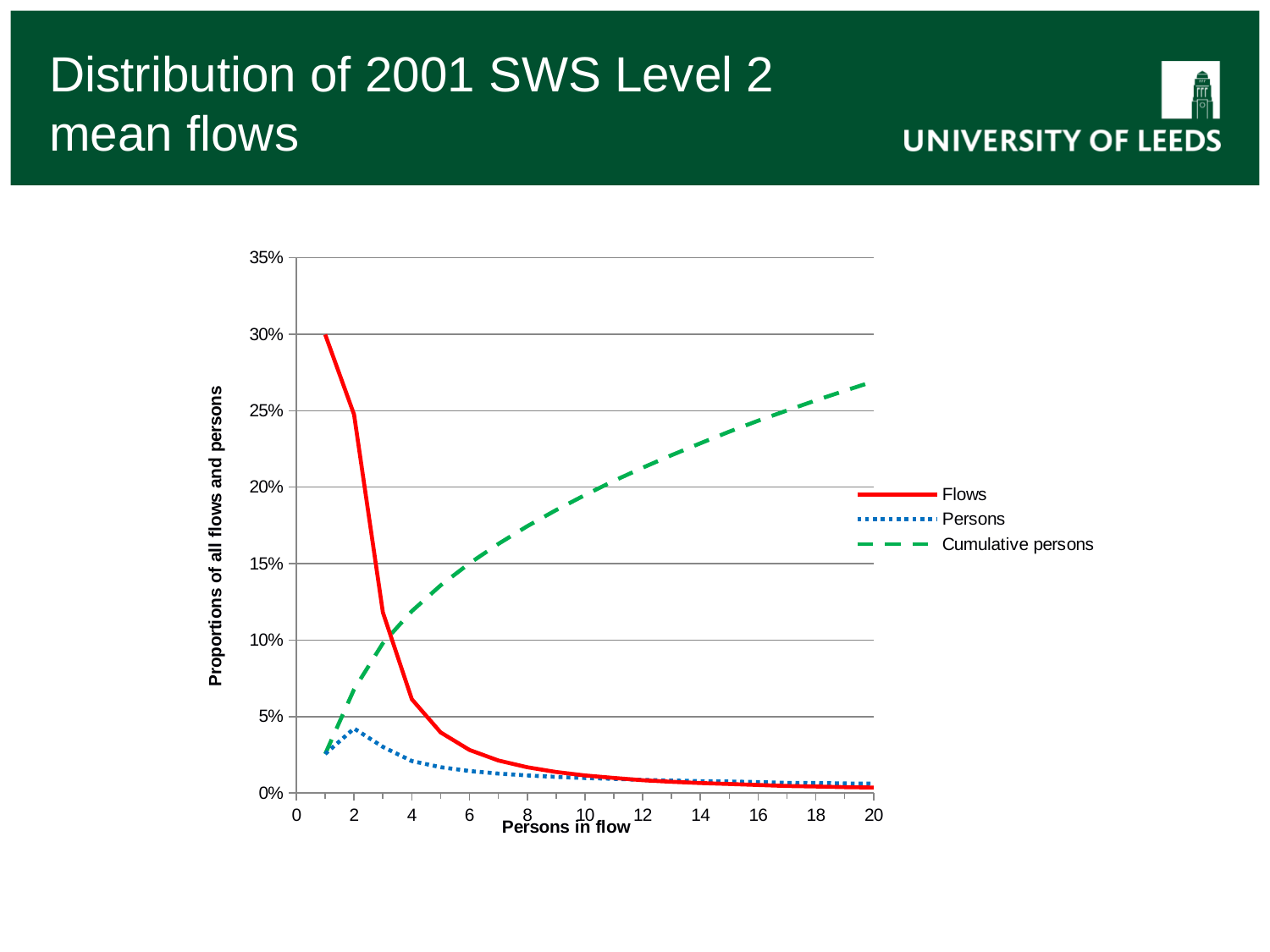
How many series does the legend list? 3 Is the value of Cumulative persons at 20 persons in flow greater or less than 25%? greater Is the value of Flows at 1 person in flow greater or less than 25%? greater What kind of chart is shown on the slide? line chart Is the value of Flows at 10 persons in flow greater or less than 5%? less What is the title of the horizontal axis? Persons in flow At 20 persons in flow, which series has the larger value, Flows or Cumulative persons? Cumulative persons Does the Flows series rise or fall as Persons in flow increases? fall At 2 persons in flow, which series has the larger value, Flows or Persons? Flows Does the Cumulative persons series rise or fall as Persons in flow increases? rise What is the title of the vertical axis? Proportions of all flows and persons